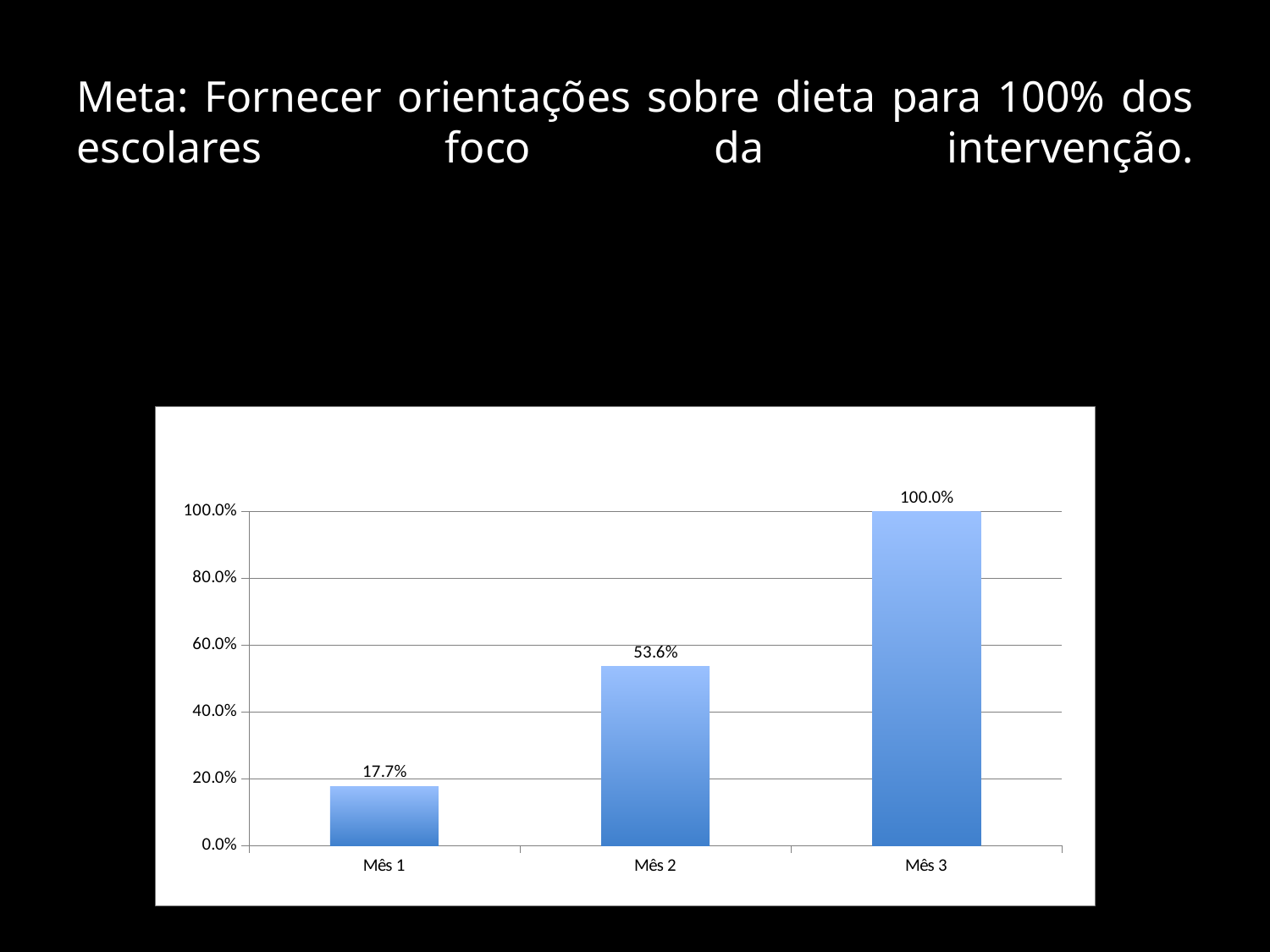
What is the value for Mês 1? 17.7% What is the difference between the values for Mês 3 and Mês 2? 46.4% What is the value for Mês 3? 100.0% Which month has the highest value? Mês 3 Which is larger, the value for Mês 1 or the value for Mês 2? Mês 2 How many categories are shown on the x axis? 3 Which month has the lowest value? Mês 1 What kind of chart is shown on the slide? bar chart Is the value for Mês 2 greater or less than 40.0%? greater What is the value for Mês 2? 53.6% Do the values rise or fall from Mês 1 to Mês 3? rise What is the difference between the values for Mês 2 and Mês 1? 35.9%